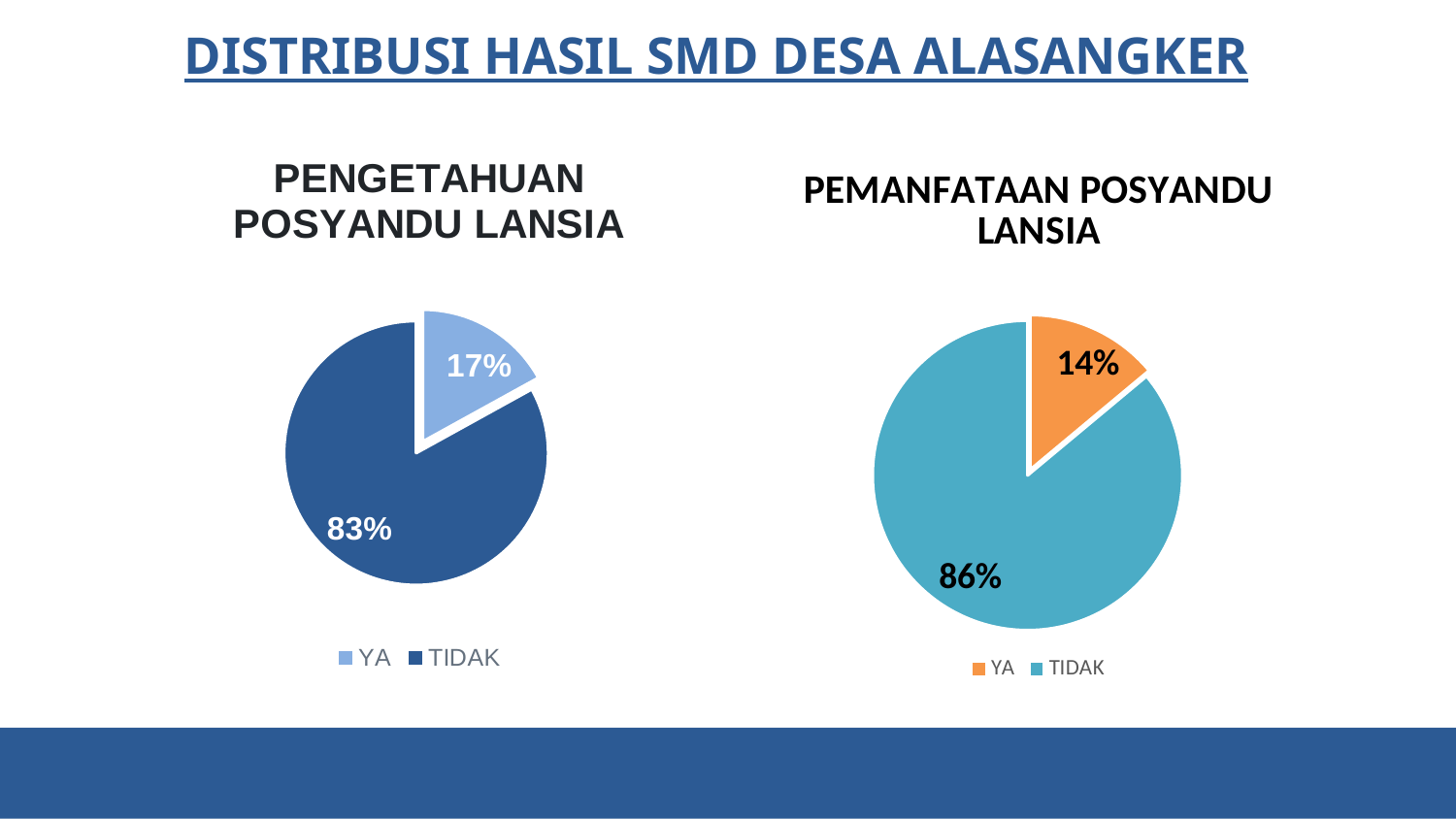
In the 'PEMANFATAAN POSYANDU LANSIA' chart, what is the value for YA? 14% In the 'PEMANFATAAN POSYANDU LANSIA' chart, what is the value for TIDAK? 86% Which is larger: the YA value in the 'PENGETAHUAN POSYANDU LANSIA' chart or the YA value in the 'PEMANFATAAN POSYANDU LANSIA' chart? PENGETAHUAN POSYANDU LANSIA What kind of chart is the 'PEMANFATAAN POSYANDU LANSIA' chart? Pie chart In the 'PENGETAHUAN POSYANDU LANSIA' chart, which category has the largest slice? TIDAK In the 'PEMANFATAAN POSYANDU LANSIA' chart, which category has the smallest slice? YA How many categories does the legend of the 'PENGETAHUAN POSYANDU LANSIA' chart list? 2 In the 'PENGETAHUAN POSYANDU LANSIA' chart, what is the value for TIDAK? 83% In the 'PEMANFATAAN POSYANDU LANSIA' chart, what colour is the YA slice? Orange In the 'PEMANFATAAN POSYANDU LANSIA' chart, what is the difference between the TIDAK and YA values? 72% In the 'PENGETAHUAN POSYANDU LANSIA' chart, what is the difference between the TIDAK and YA values? 66% In the 'PENGETAHUAN POSYANDU LANSIA' chart, what is the value for YA? 17%